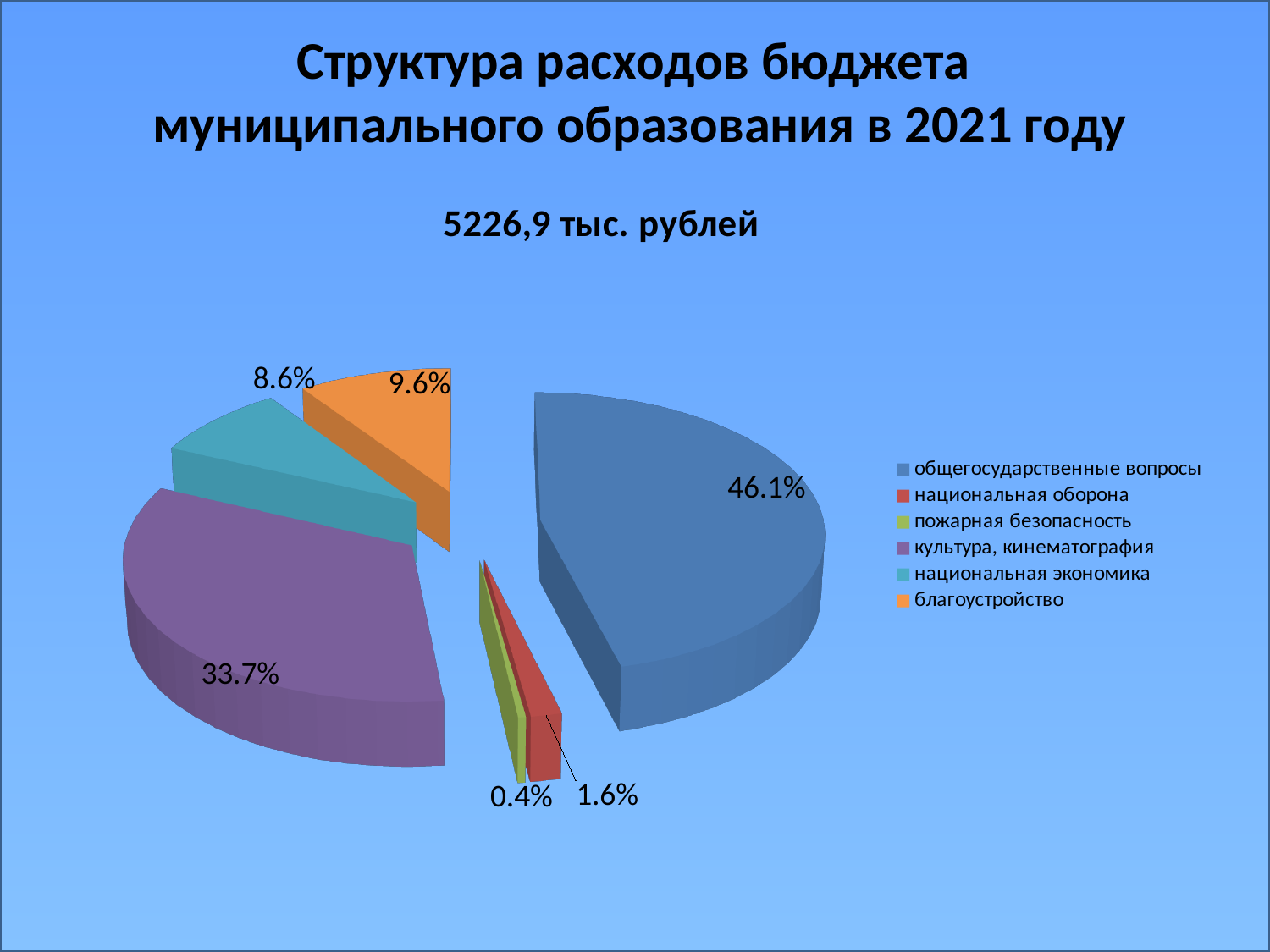
How many categories does the legend list? 6 What share of the budget expenditure goes to пожарная безопасность? 0.4% Which category has the smallest share of the pie? пожарная безопасность Which category has the largest share of the pie? общегосударственные вопросы Which has a larger share: благоустройство or национальная экономика? благоустройство What total amount in thousand rubles is stated below the chart title? 5226,9 тыс. рублей What share of the budget expenditure goes to национальная экономика? 8.6% What share of the budget expenditure goes to общегосударственные вопросы? 46.1% What share of the budget expenditure goes to культура, кинематография? 33.7% What is the difference in percentage points between общегосударственные вопросы and культура, кинематография? 12.4 What kind of chart is shown on the slide? pie chart What share of the budget expenditure goes to благоустройство? 9.6%